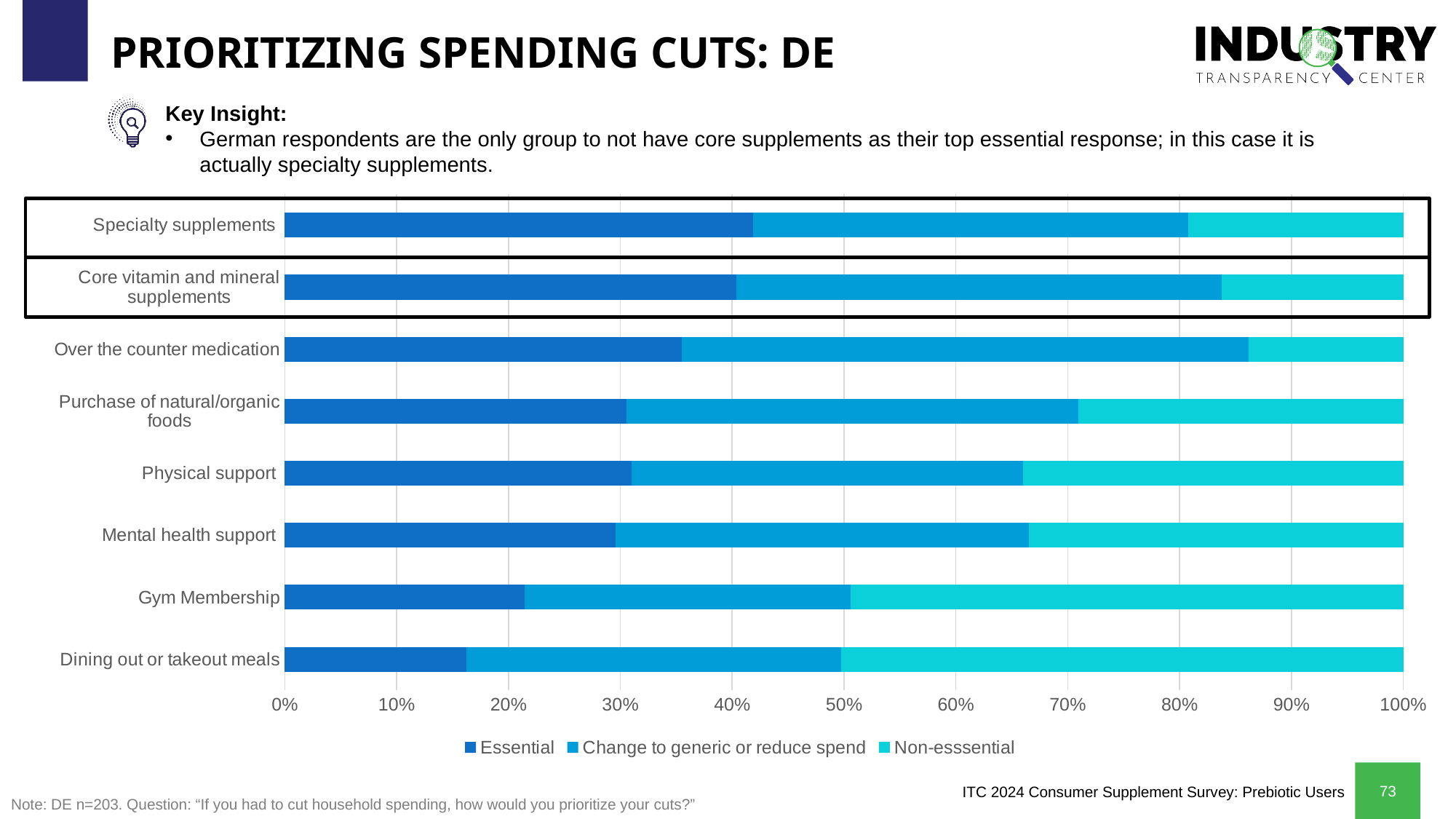
Is the Essential share for Specialty supplements greater or less than 40%? greater What kind of chart is shown on the slide? Stacked bar chart How many categories are plotted on the chart? 8 Which has the larger Essential share: Over the counter medication or Mental health support? Over the counter medication How many series does the legend list? 3 What are the three series listed in the chart legend? Essential, Change to generic or reduce spend, Non-esssential Is the Essential share for Dining out or takeout meals greater or less than 20%? less Is the Essential share for Over the counter medication greater or less than 40%? less What is the title of the slide containing the chart? PRIORITIZING SPENDING CUTS: DE Which category has the largest Essential share? Specialty supplements Which category has the smallest Essential share? Dining out or takeout meals Which has the larger Essential share: Gym Membership or Dining out or takeout meals? Gym Membership